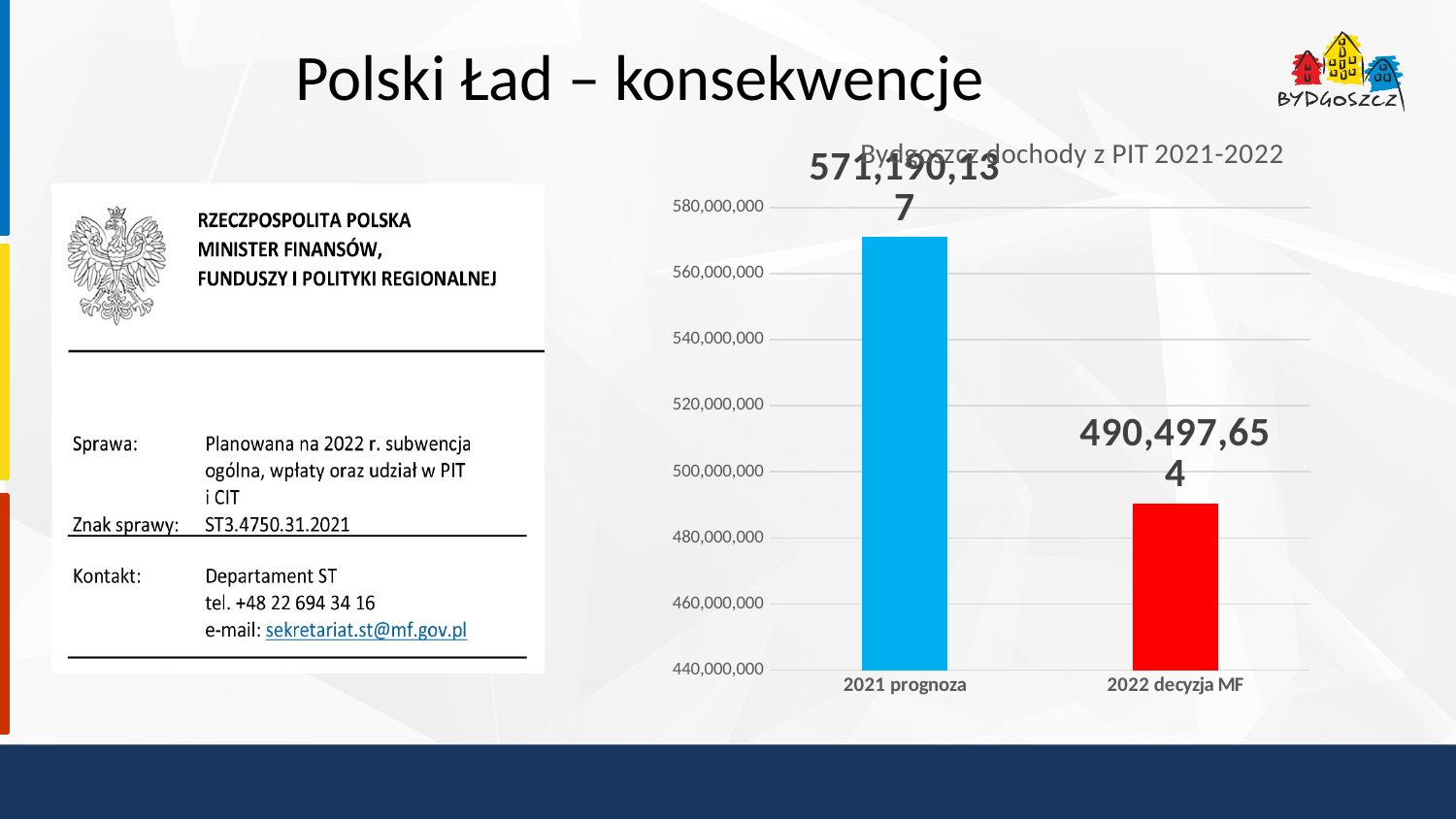
Which category has the highest value? 2021 prognoza What is the value for 2022 decyzja MF? 490,497,654 Which is larger, the value for 2021 prognoza or for 2022 decyzja MF? 2021 prognoza What is the value for 2021 prognoza? 571,190,137 What is the difference between the 2021 prognoza and 2022 decyzja MF values? 80,692,483 What kind of chart is shown on the slide? bar chart What is the title of the chart? Bydgoszcz dochody z PIT 2021-2022 Is the value for 2022 decyzja MF greater or less than 500,000,000? less Which category has the lowest value? 2022 decyzja MF How many categories are shown on the x axis of the chart? 2 Do the values rise or fall from 2021 prognoza to 2022 decyzja MF? fall Is the value for 2021 prognoza greater or less than 560,000,000? greater